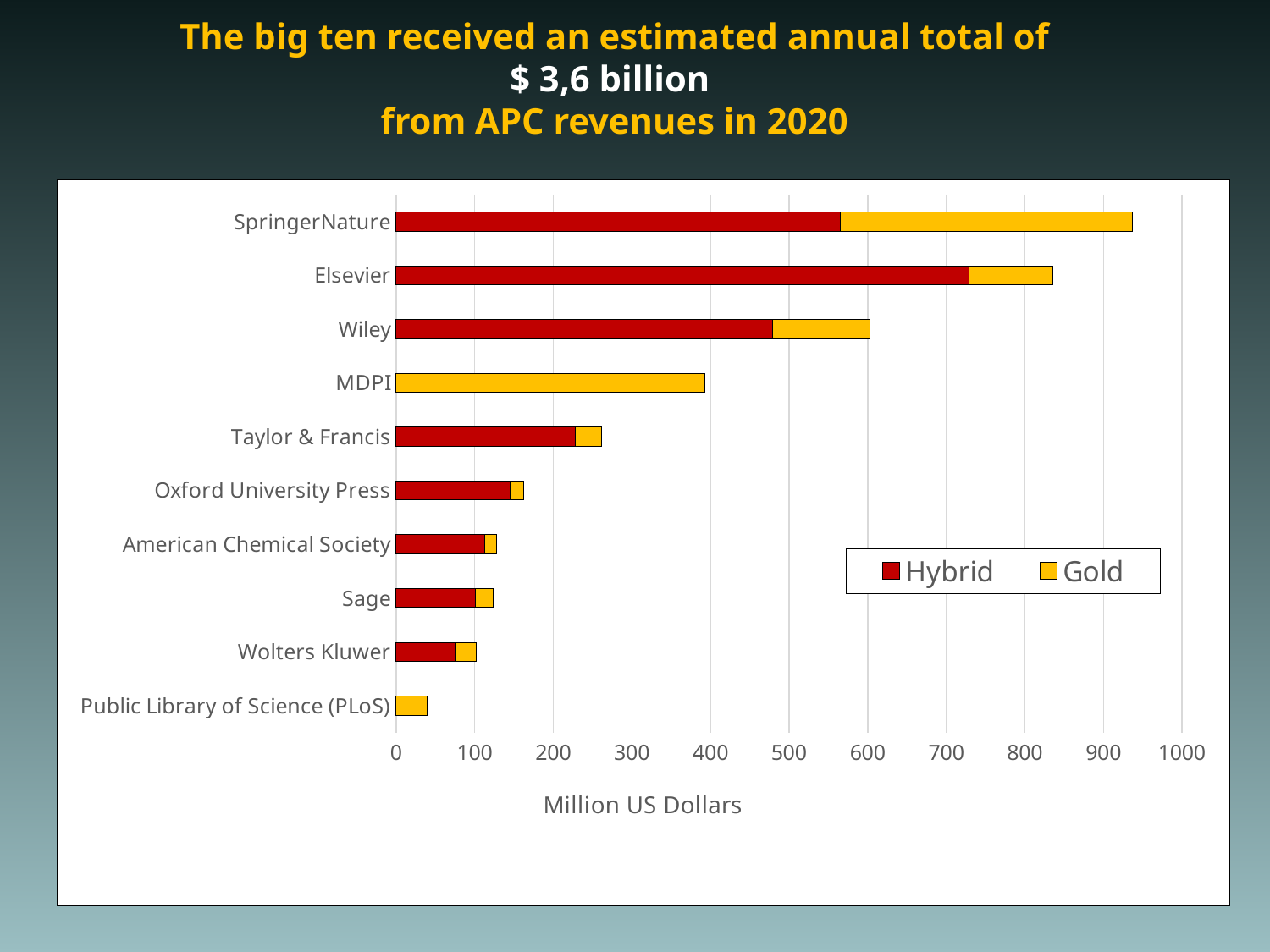
Is the total value for MDPI greater or less than 300? greater What is the title of the horizontal axis? Million US Dollars How many publishers are listed on the chart? 10 Is the total value for SpringerNature greater or less than 900? greater Is the total value for Elsevier greater or less than 800? greater What are the two series named in the legend? Hybrid and Gold Which publisher has the longest total bar? SpringerNature Which publisher has the shortest total bar? Public Library of Science (PLoS) What kind of chart is shown on the slide? bar chart Which publisher has a larger total bar, Elsevier or Wiley? Elsevier How many series does the legend list? 2